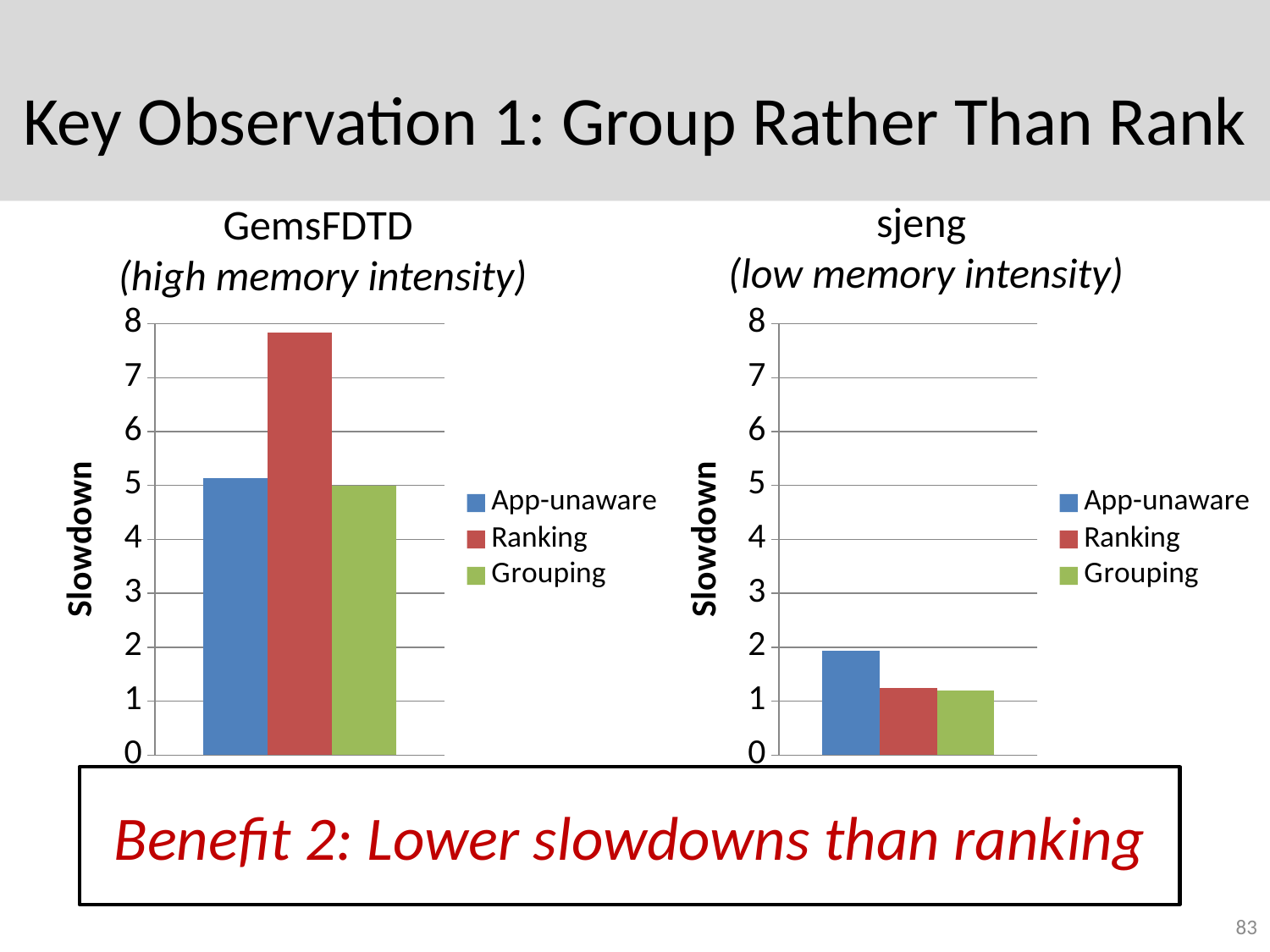
In the sjeng chart, which series has the highest slowdown? App-unaware In the sjeng chart, is the slowdown for Ranking greater or less than 1? greater In the GemsFDTD chart, is the slowdown for Grouping greater or less than 4? greater What is the y-axis label of the sjeng chart? Slowdown How many series does the legend of the sjeng chart list? 3 In the GemsFDTD chart, which is larger, the slowdown for Ranking or for Grouping? Ranking In the GemsFDTD chart, is the slowdown for App-unaware greater or less than 6? less In the sjeng chart, which is larger, the slowdown for App-unaware or for Grouping? App-unaware In the GemsFDTD chart, which series has the highest slowdown? Ranking What kind of chart is the GemsFDTD chart? bar chart